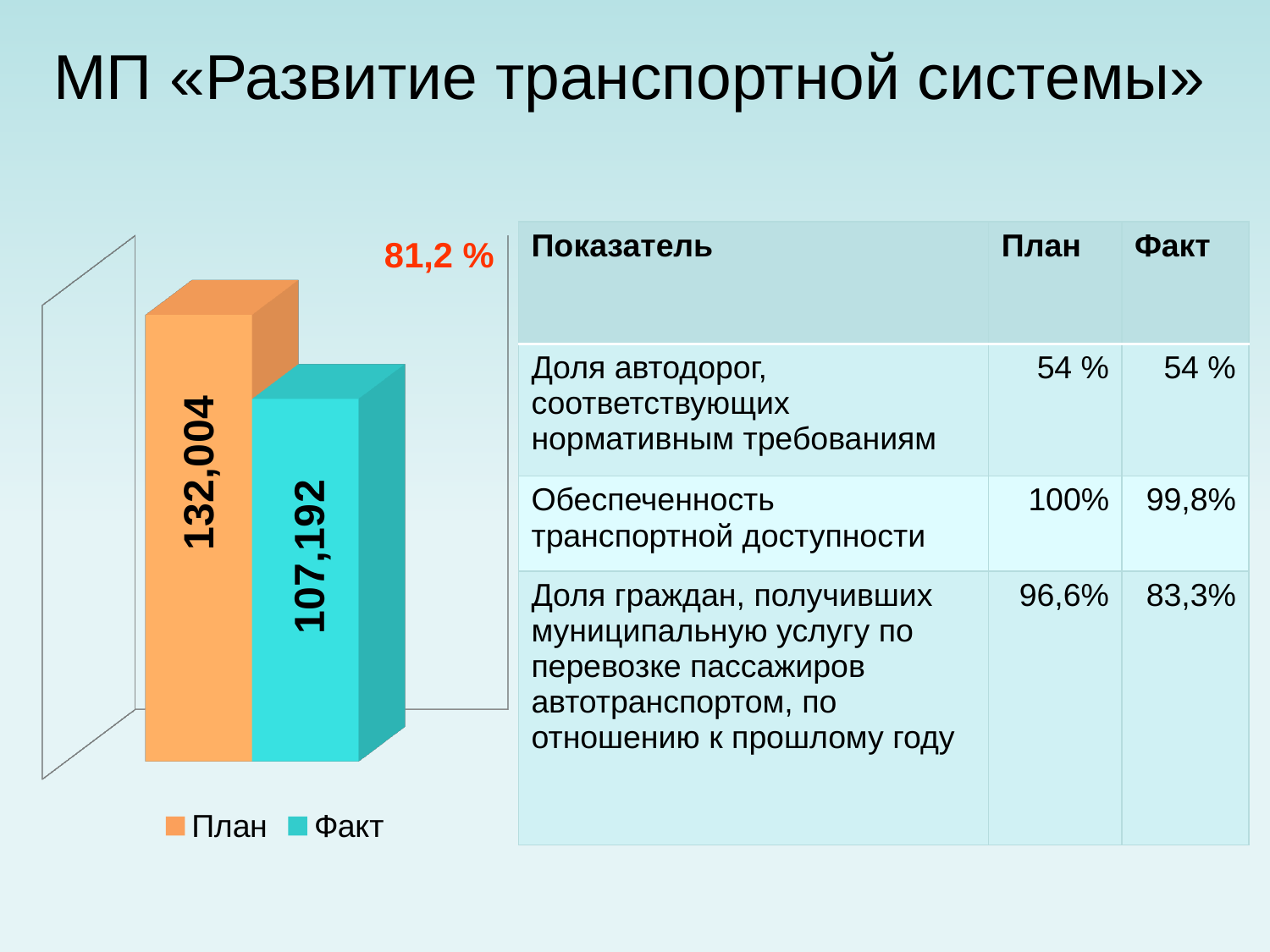
How many series does the chart legend list? 2 What colour is the Факт bar in the chart? Turquoise Which series has the highest value in the chart? План Which series has the lowest value in the chart? Факт What is the value of the Факт bar in the chart? 107,192 How many bars are plotted in the chart? 2 Which bar in the chart is higher, План or Факт? План What kind of chart is shown on the left of the slide? Bar chart What is the difference between the План and Факт values in the chart? 24,812 What percentage is printed in red above the chart? 81,2 % What is the value of the План bar in the chart? 132,004